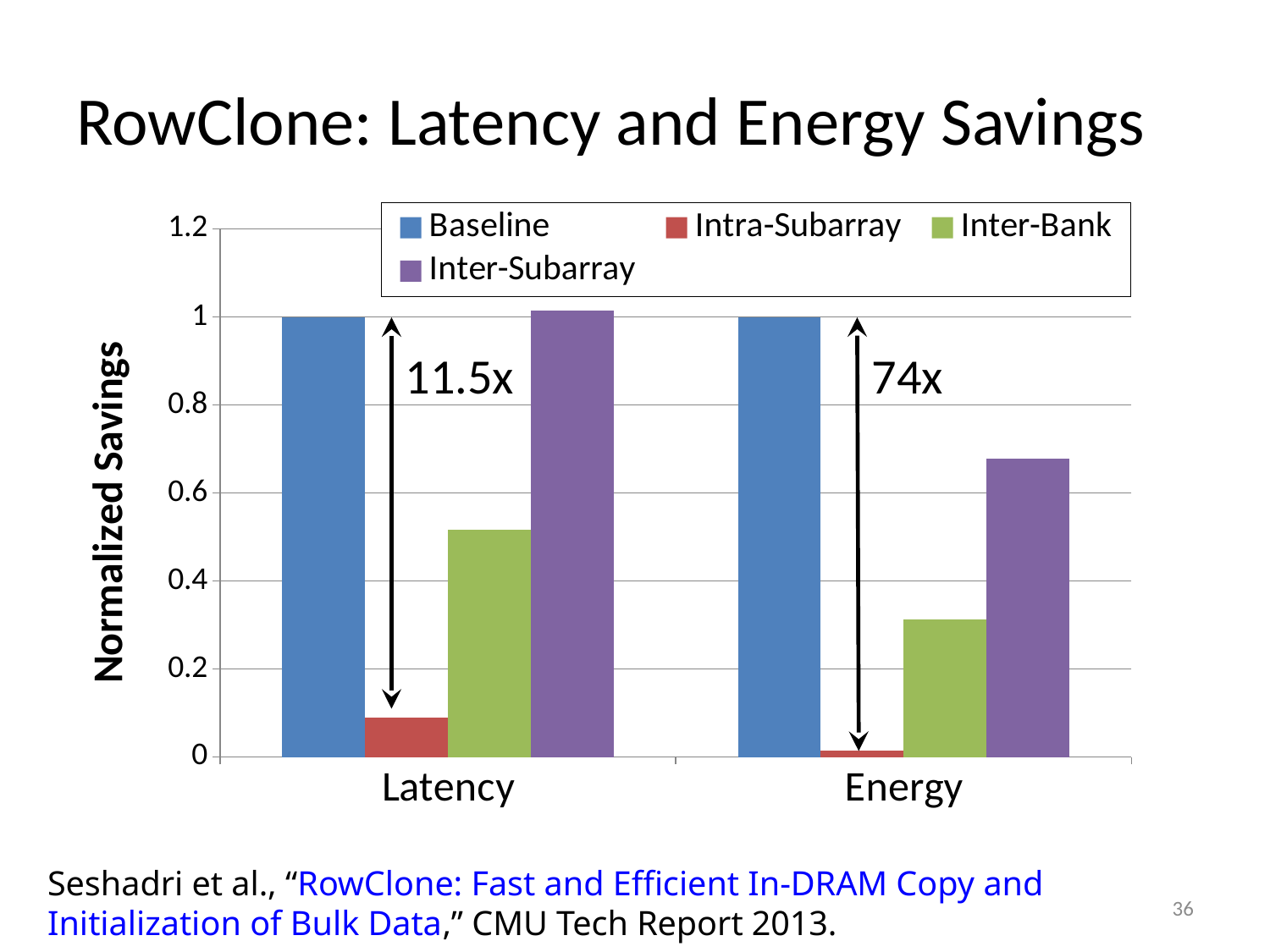
Which series has the lowest value for Energy? Intra-Subarray Which series has the highest value for Energy? Baseline What is the Baseline value for Latency? 1 Is the Intra-Subarray value for Latency greater or less than 0.2? less What is the Baseline value for Energy? 1 Is the Inter-Subarray value for Energy greater or less than 0.6? greater How many categories are shown on the x axis? 2 Which is larger, the Inter-Bank value for Latency or the Inter-Bank value for Energy? Latency How many series does the legend list? 4 Is the Inter-Bank value for Latency greater or less than 0.6? less What kind of chart is shown on the slide? bar chart What improvement factor is annotated above the Energy bars? 74x